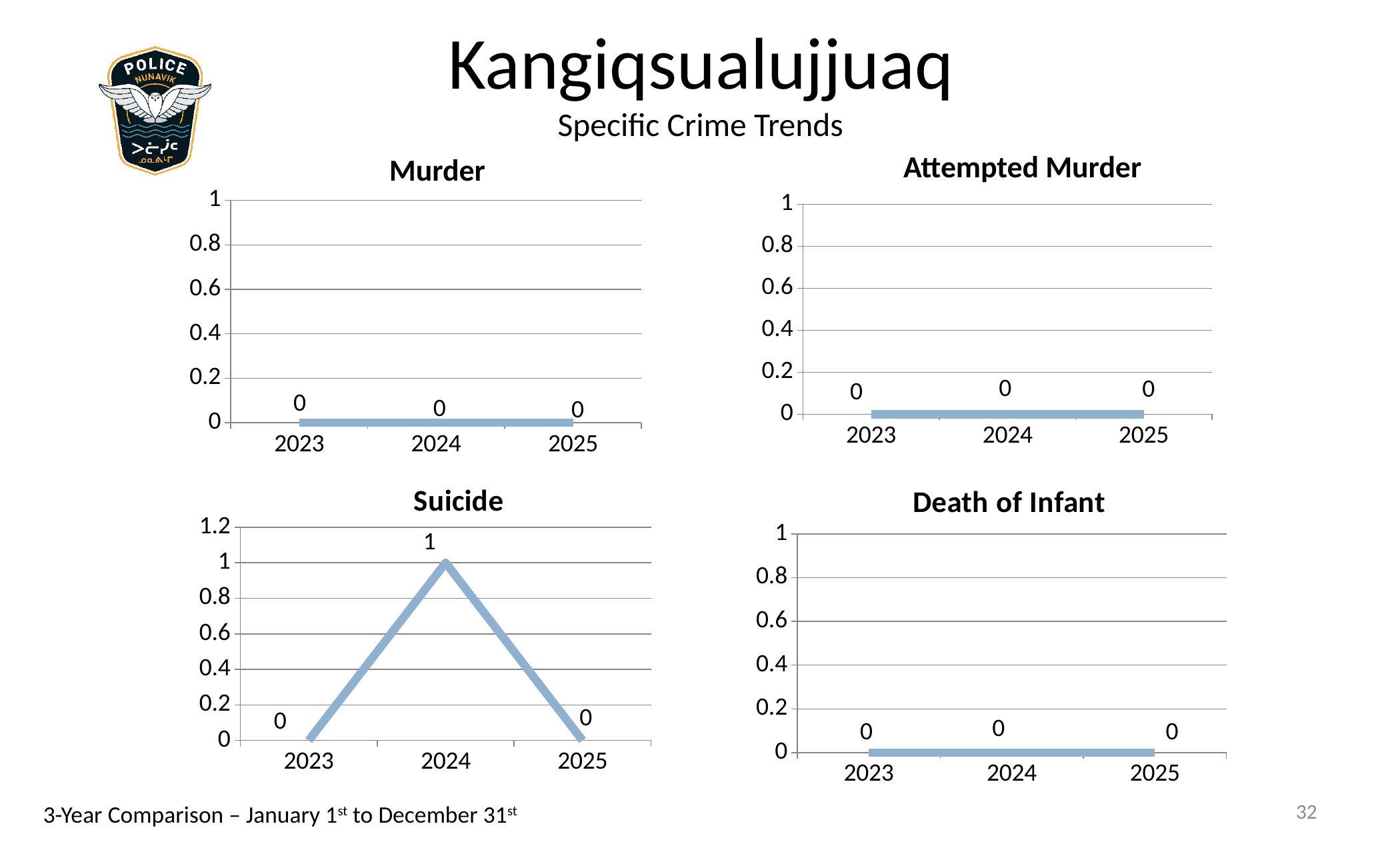
In the Murder chart, what is the value for 2025? 0 In the Suicide chart, does the value rise or fall from 2024 to 2025? fall In the Suicide chart, what is the difference between the values for 2024 and 2025? 1 In the Suicide chart, which is larger, the value for 2024 or the value for 2023? 2024 In the Suicide chart, what is the value for 2024? 1 How many years are plotted in the Murder chart? 3 In the Suicide chart, what is the value for 2023? 0 In the Attempted Murder chart, what is the value for 2024? 0 In the Suicide chart, which year has the highest value? 2024 In the Death of Infant chart, what is the value for 2023? 0 How many charts are shown on the slide? 4 What kind of chart is the Suicide chart? line chart